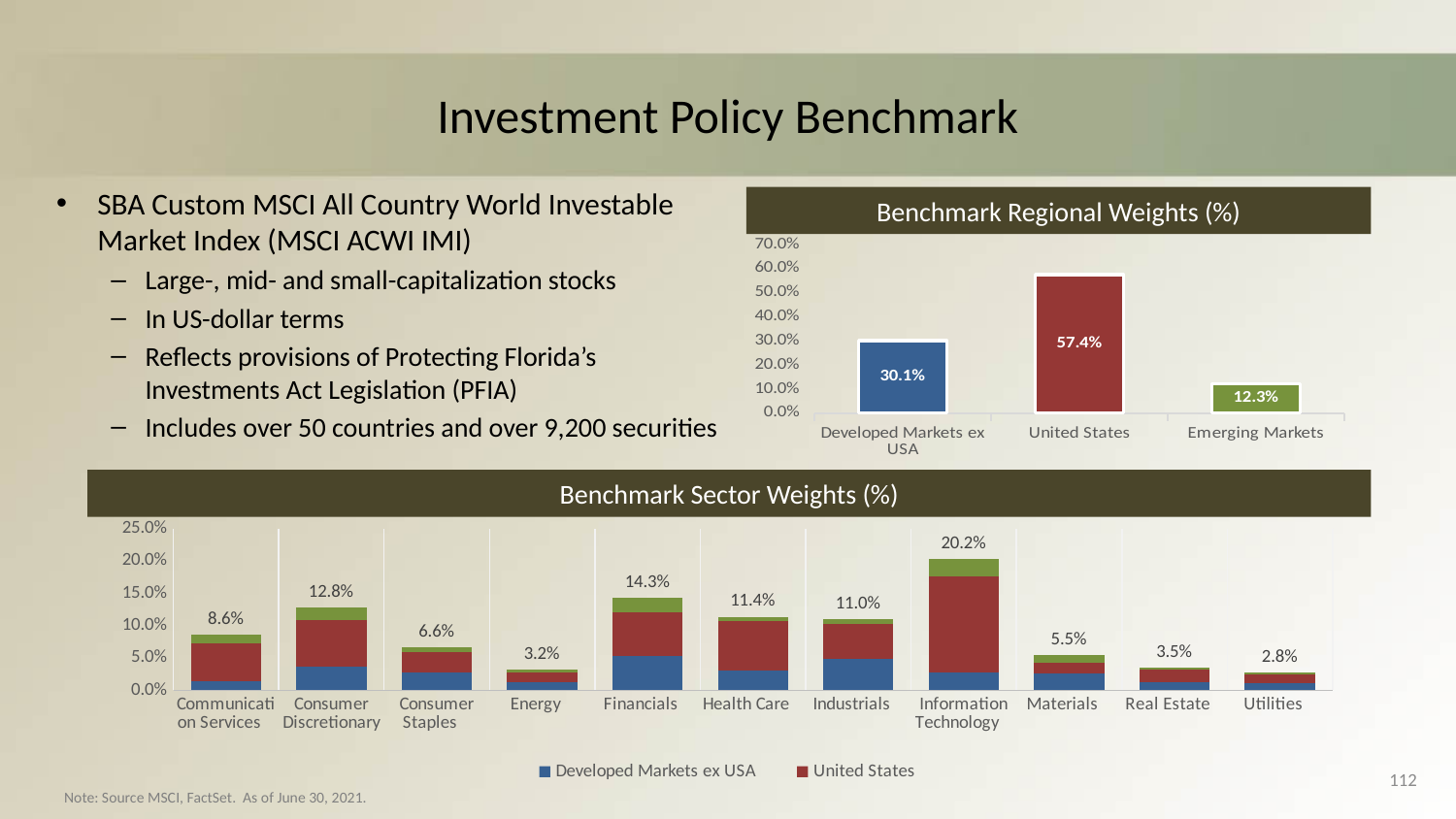
In the Benchmark Sector Weights (%) chart, which sector has the lowest total weight? Utilities In the Benchmark Sector Weights (%) chart, how many series does the legend list? 2 In the Benchmark Sector Weights (%) chart, what is the total weight labeled for Financials? 14.3% What kind of chart is the Benchmark Sector Weights (%) chart? Stacked bar chart In the Benchmark Sector Weights (%) chart, how many sectors are shown on the x axis? 11 In the Benchmark Sector Weights (%) chart, which is larger, the total for Health Care or the total for Industrials? Health Care In the Benchmark Regional Weights (%) chart, what is the difference between the United States and Developed Markets ex USA weights? 27.3% In the Benchmark Regional Weights (%) chart, which region has the highest weight? United States In the Benchmark Sector Weights (%) chart, what is the total weight labeled for Information Technology? 20.2% In the Benchmark Regional Weights (%) chart, how many regions are shown? 3 In the Benchmark Regional Weights (%) chart, what is the value for United States? 57.4% In the Benchmark Regional Weights (%) chart, what is the value for Emerging Markets? 12.3%